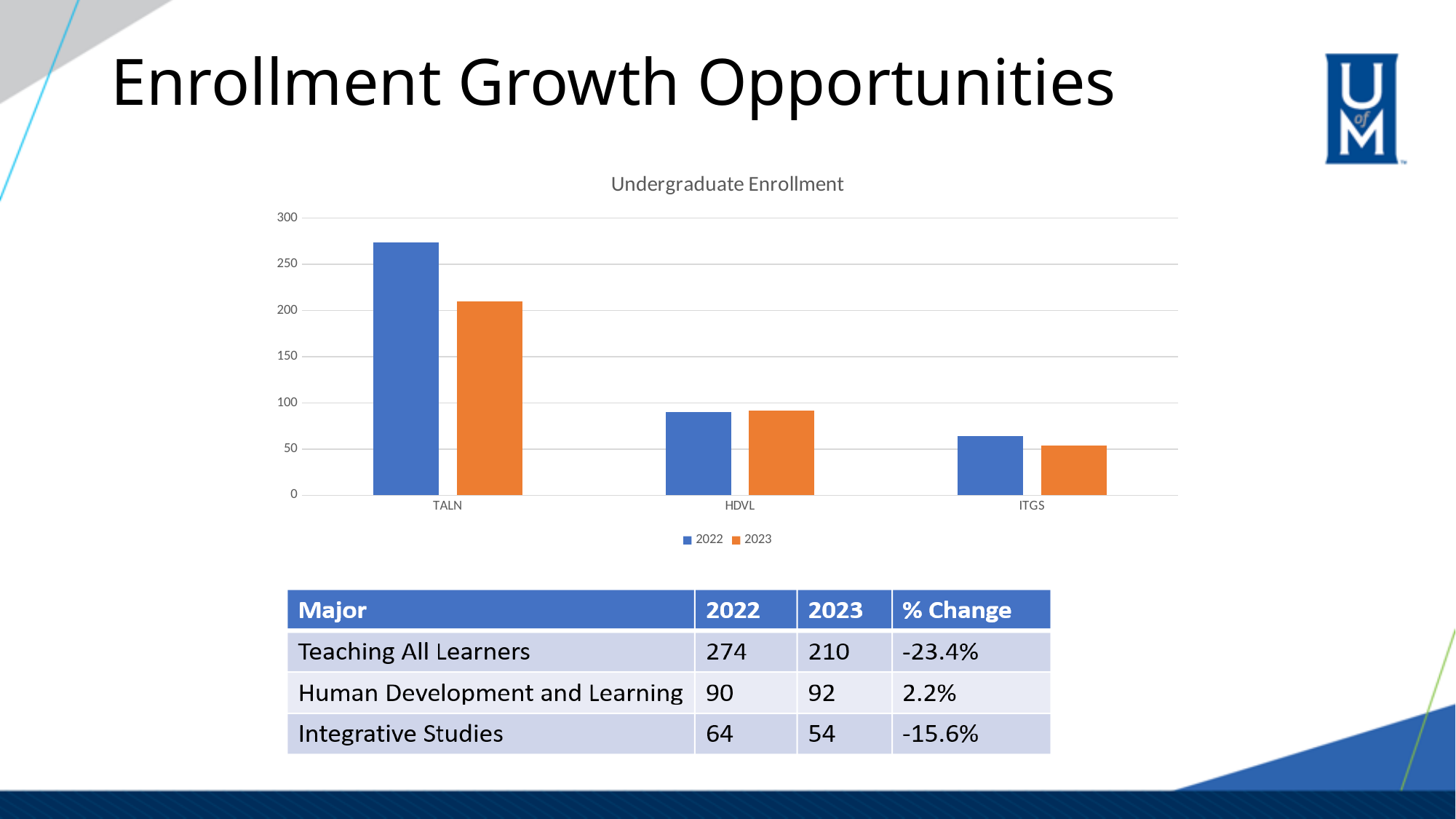
In the Undergraduate Enrollment chart, which is larger for TALN: the 2022 value or the 2023 value? 2022 In the Undergraduate Enrollment chart, is the 2022 value for TALN greater or less than 250? greater Which series in the Undergraduate Enrollment chart is shown in orange? 2023 According to the slide, what was the 2022 enrollment for Teaching All Learners? 274 How many series does the legend of the Undergraduate Enrollment chart list? 2 What type of chart is shown under the title "Undergraduate Enrollment"? bar chart Which category has the highest 2022 value in the Undergraduate Enrollment chart? TALN Which category has the lowest 2023 value in the Undergraduate Enrollment chart? ITGS In the Undergraduate Enrollment chart, is the 2023 value for HDVL greater or less than 100? less According to the slide, what is the difference between the 2022 and 2023 enrollment for Integrative Studies? 10 How many categories are shown on the x axis of the Undergraduate Enrollment chart? 3